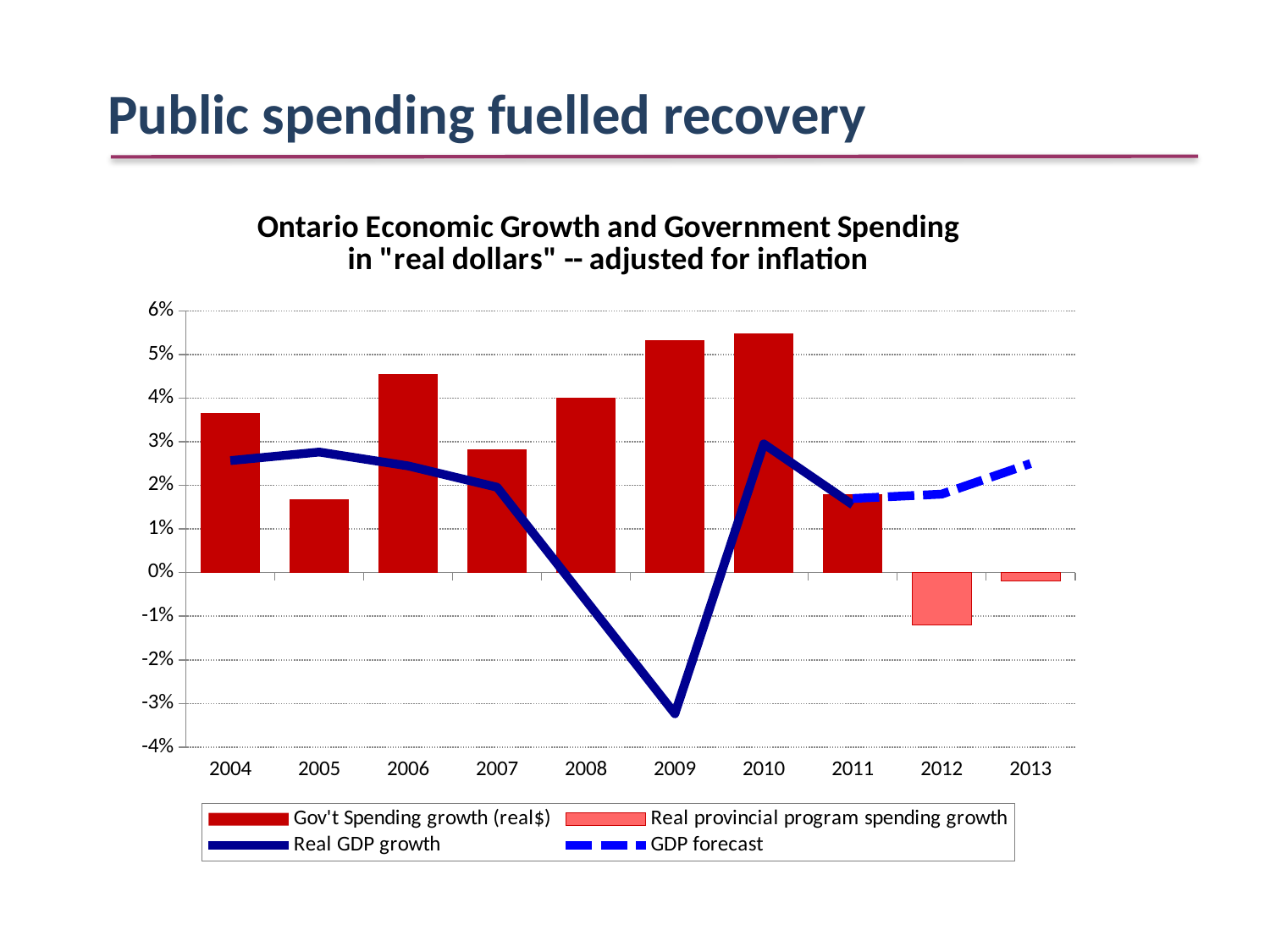
What is the title of the chart? Ontario Economic Growth and Government Spending in "real dollars" -- adjusted for inflation In which year is Real GDP growth lowest? 2009 How many series does the legend list? 4 Is the Real provincial program spending growth value for 2012 greater or less than -1%? less How many years are shown on the x axis? 10 Is the Gov't Spending growth (real$) value for 2009 greater or less than 5%? greater What kind of chart is shown on the slide? A combined bar and line chart Does the GDP forecast rise or fall from 2012 to 2013? rise Which year has the larger Gov't Spending growth (real$), 2006 or 2007? 2006 Which series is drawn as a dashed line? GDP forecast In which year is Gov't Spending growth (real$) highest? 2010 Is the Real GDP growth value for 2009 greater or less than -3%? less